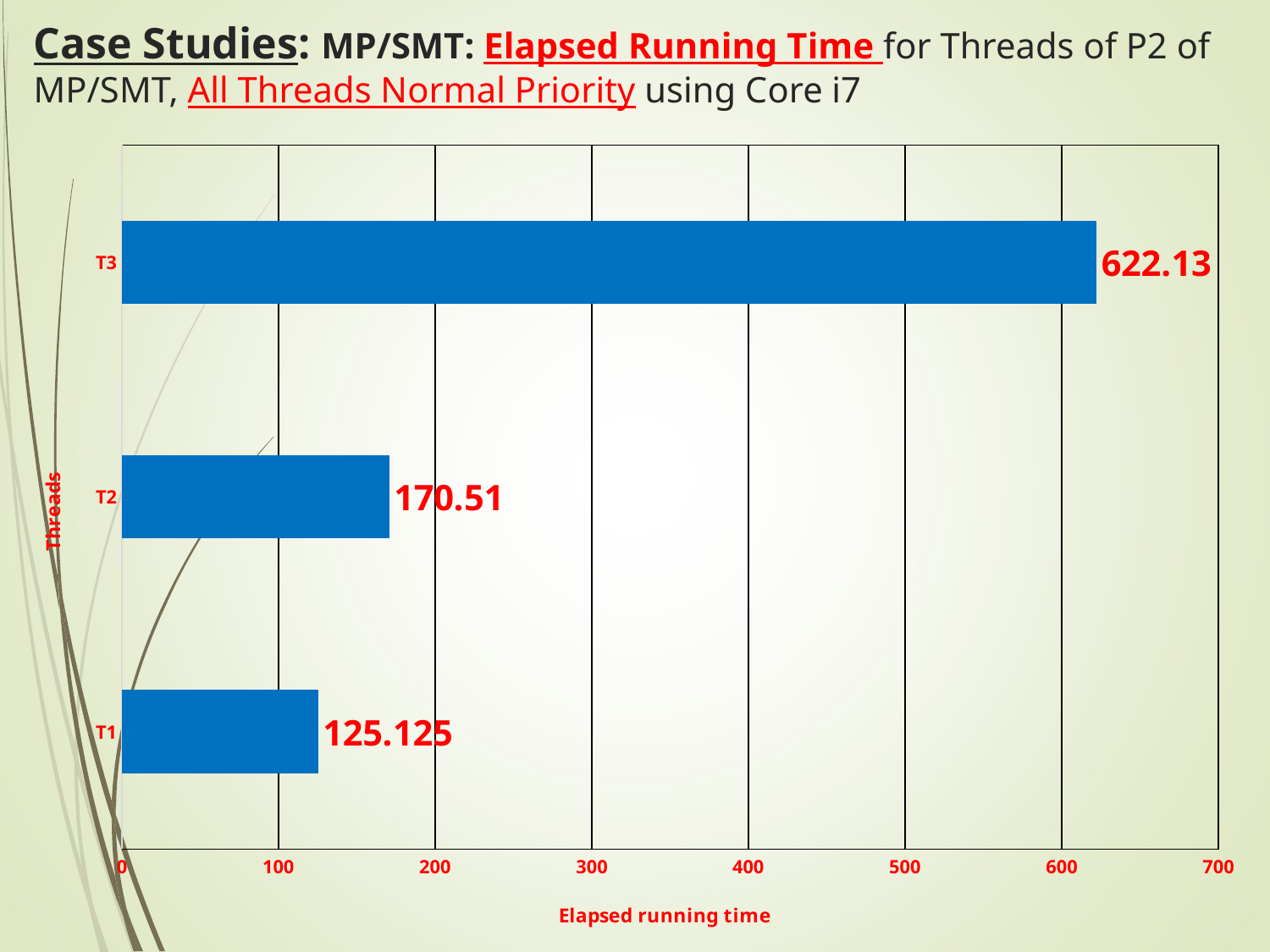
Is the elapsed running time for T3 greater or less than 600? greater What is the elapsed running time for thread T3? 622.13 What is the elapsed running time for thread T2? 170.51 Which thread has the lowest elapsed running time? T1 What kind of chart is shown on the slide? bar chart What is the difference in elapsed running time between T2 and T1? 45.385 What is the difference in elapsed running time between T3 and T2? 451.62 How many threads are shown in the chart? 3 Which thread has the highest elapsed running time? T3 Which thread has a larger elapsed running time, T1 or T2? T2 What is the label of the horizontal axis of the chart? Elapsed running time What is the elapsed running time for thread T1? 125.125